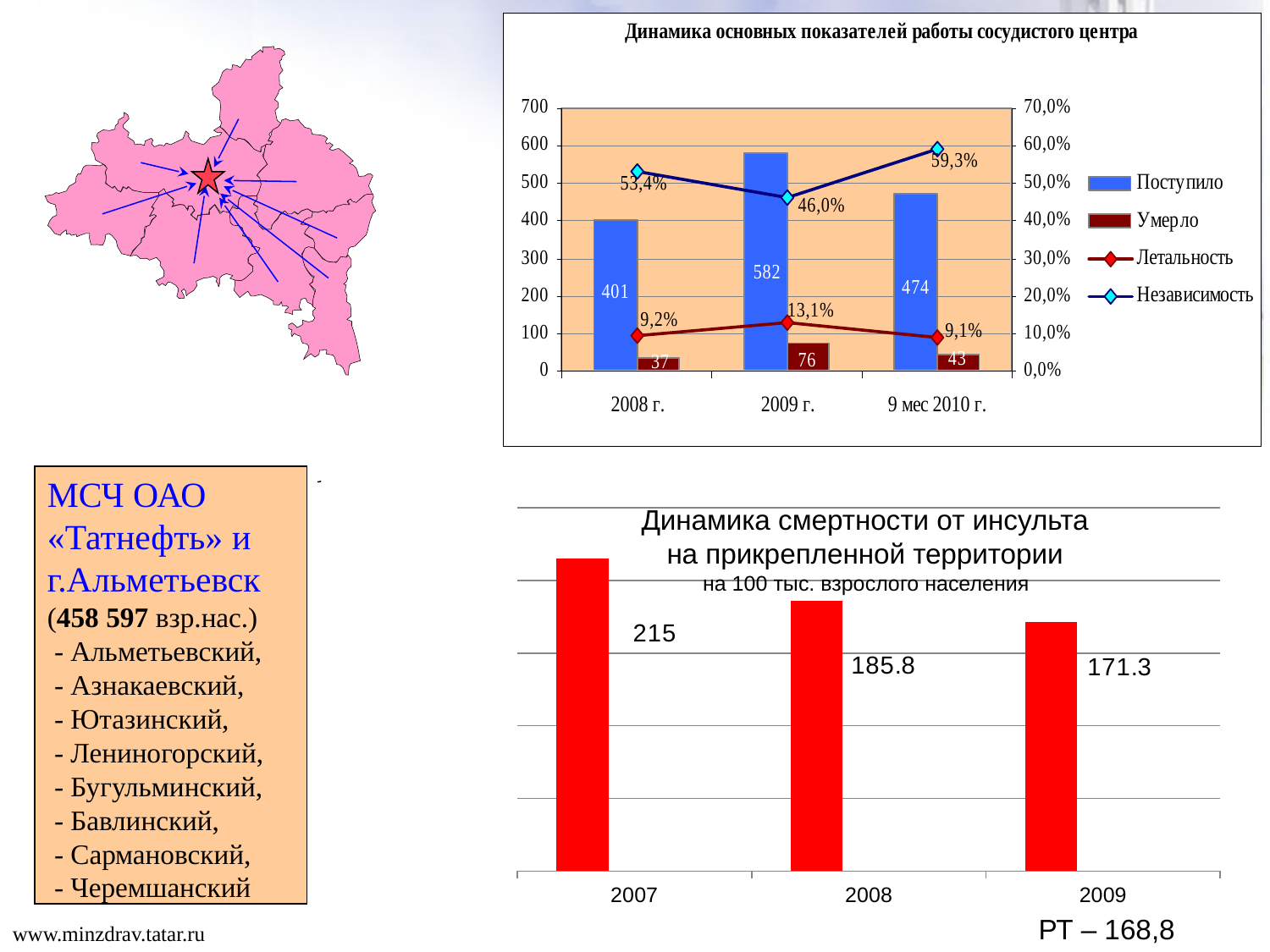
In the chart 'Динамика смертности от инсульта на прикрепленной территории', do the values rise or fall from 2007 to 2009? fall In the chart 'Динамика смертности от инсульта на прикрепленной территории', what is the difference between the 2007 and 2009 values? 43.7 In the chart 'Динамика смертности от инсульта на прикрепленной территории', which year has the highest value? 2007 In the chart 'Динамика основных показателей работы сосудистого центра', what is the difference between Поступило in 2009 г. and 2008 г.? 181 What kind of chart is 'Динамика смертности от инсульта на прикрепленной территории'? bar chart In the chart 'Динамика основных показателей работы сосудистого центра', what is the Летальность value for 9 мес 2010 г.? 9,1% In the chart 'Динамика основных показателей работы сосудистого центра', which period has the lowest Умерло value? 2008 г. In the chart 'Динамика основных показателей работы сосудистого центра', what is the value of Умерло for 2008 г.? 37 In the chart 'Динамика основных показателей работы сосудистого центра', how many series does the legend list? 4 In the chart 'Динамика смертности от инсульта на прикрепленной территории', what is the value for 2008? 185.8 In the chart 'Динамика основных показателей работы сосудистого центра', what is the value of Поступило for 2009 г.? 582 In the chart 'Динамика основных показателей работы сосудистого центра', which period has the highest Независимость value? 9 мес 2010 г.